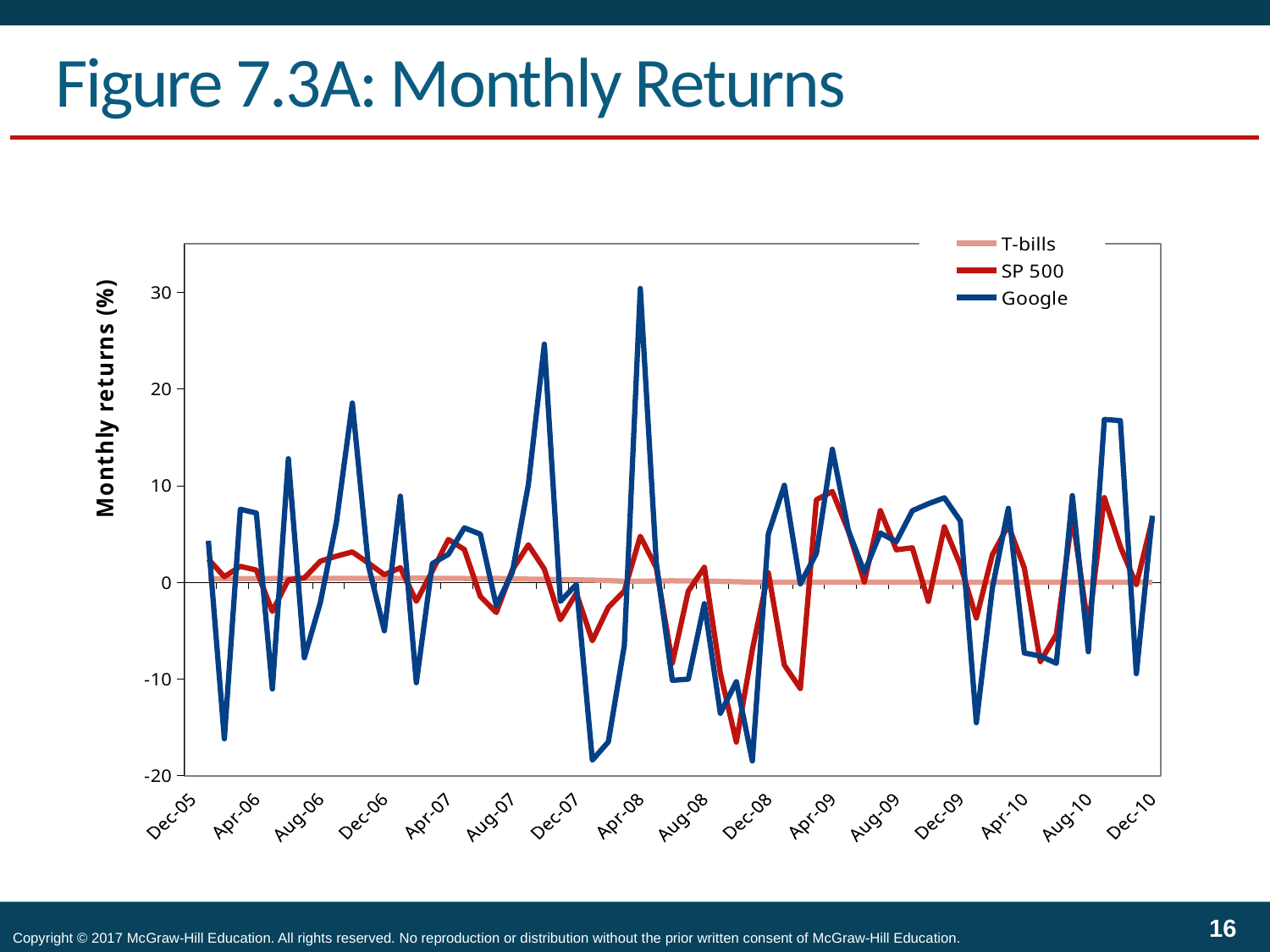
Which series reaches the highest value on the chart? Google Is the peak value for Google near Apr-08 greater or less than 20? greater Which series stays closest to zero across the whole period? T-bills Which series is larger at the peak near Dec-07, Google or SP 500? Google How many date labels are shown on the x axis? 16 What is the title of the slide's chart? Figure 7.3A: Monthly Returns What kind of chart is shown on the slide? line chart Is the lowest value for Google near Dec-08 greater or less than -10? less How many series does the legend list? 3 What is the label on the vertical axis? Monthly returns (%) Is the value for T-bills at any point greater or less than 10? less